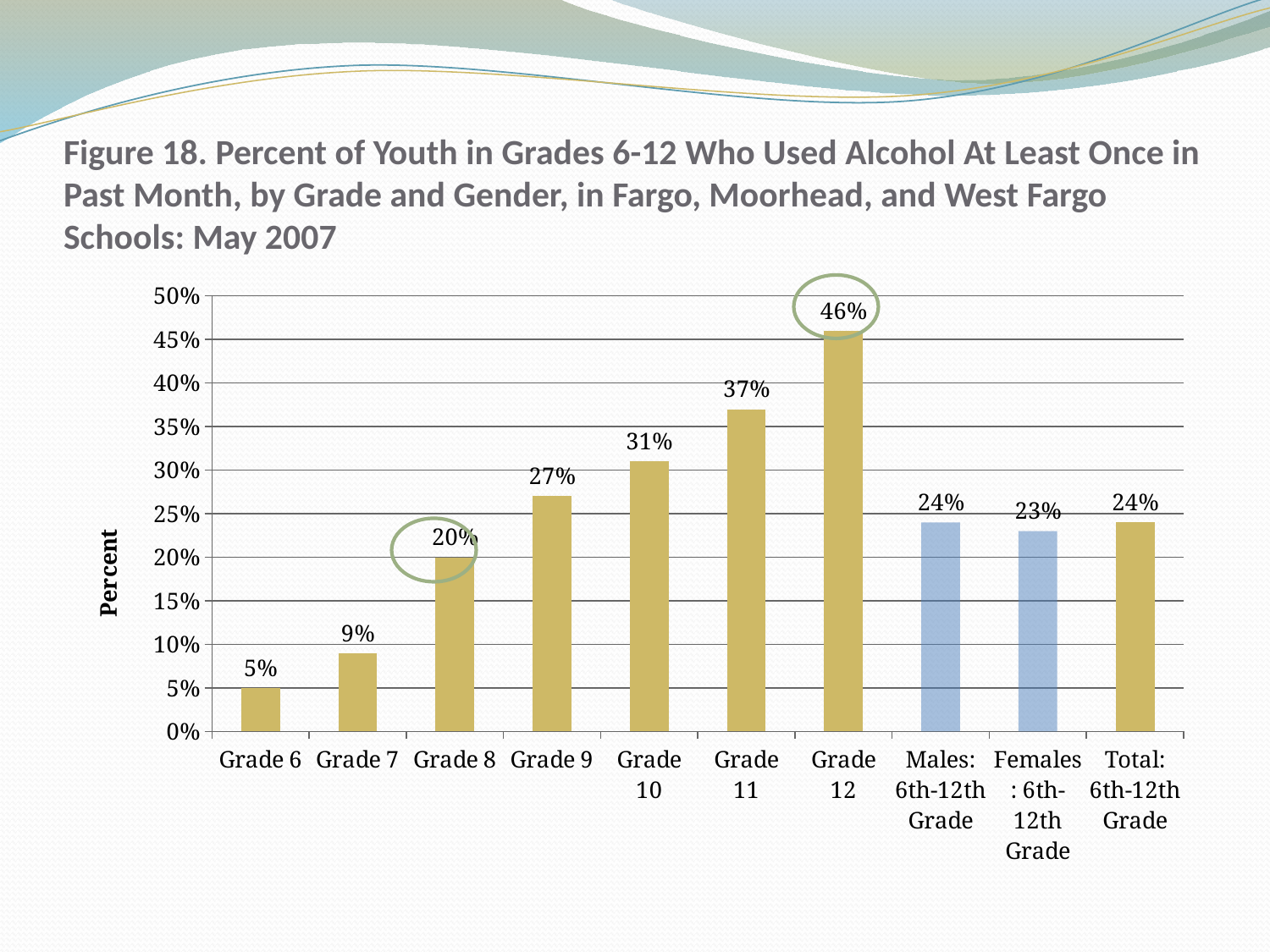
What is the difference between the Grade 11 and Grade 10 values? 6% Which grade has the highest percent of youth who used alcohol in the past month? Grade 12 Which is larger, the value for Males: 6th-12th Grade or the value for Grade 9? Grade 9 What is the value shown for Grade 12? 46% Which category has the lowest value on the chart? Grade 6 What kind of chart is shown on the slide? Bar chart What is the value shown for Females: 6th-12th Grade? 23% What is the difference between the Grade 12 value and the Grade 6 value? 41% What is the label on the vertical axis? Percent Do the values rise or fall from Grade 6 to Grade 12? Rise How many bars are shown on the chart? 10 What percent of Grade 8 youth used alcohol at least once in the past month? 20%